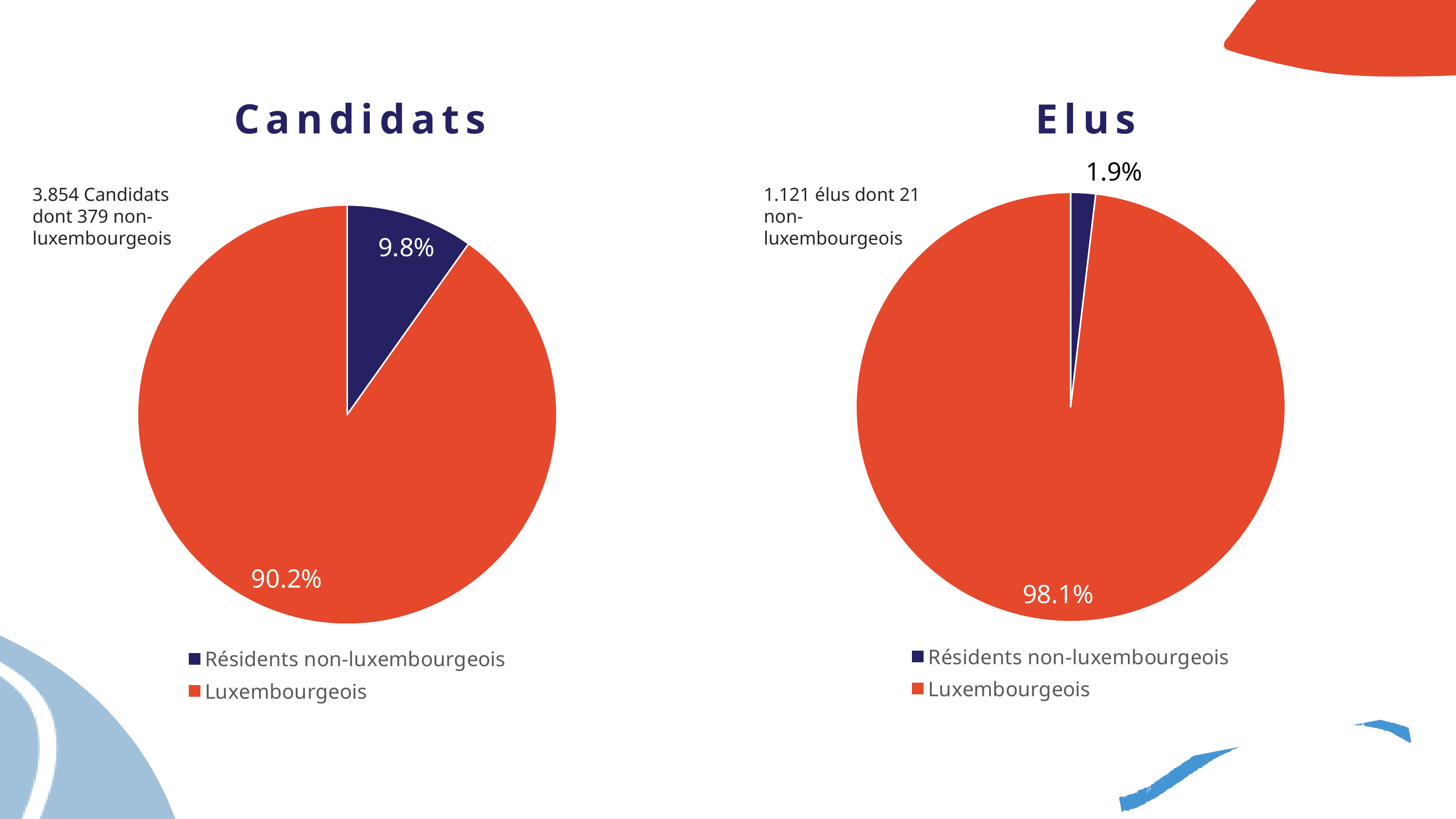
In the 'Candidats' chart, what share of the pie is 'Luxembourgeois'? 90.2% In the 'Elus' chart, what share of the pie is 'Résidents non-luxembourgeois'? 1.9% How many slices does the 'Elus' pie chart have? 2 In the 'Candidats' chart, which slice is the smallest? Résidents non-luxembourgeois What is the difference between the 'Luxembourgeois' share in the 'Elus' chart and in the 'Candidats' chart? 7.9% In the 'Elus' chart, which slice is the largest? Luxembourgeois What kind of chart is the 'Candidats' chart? Pie chart In the 'Candidats' chart, what share of the pie is 'Résidents non-luxembourgeois'? 9.8% What colour is the 'Luxembourgeois' slice in the 'Elus' chart? Orange-red How many entries does the legend of the 'Candidats' chart list? 2 Which is larger: the 'Résidents non-luxembourgeois' share in the 'Candidats' chart or in the 'Elus' chart? Candidats